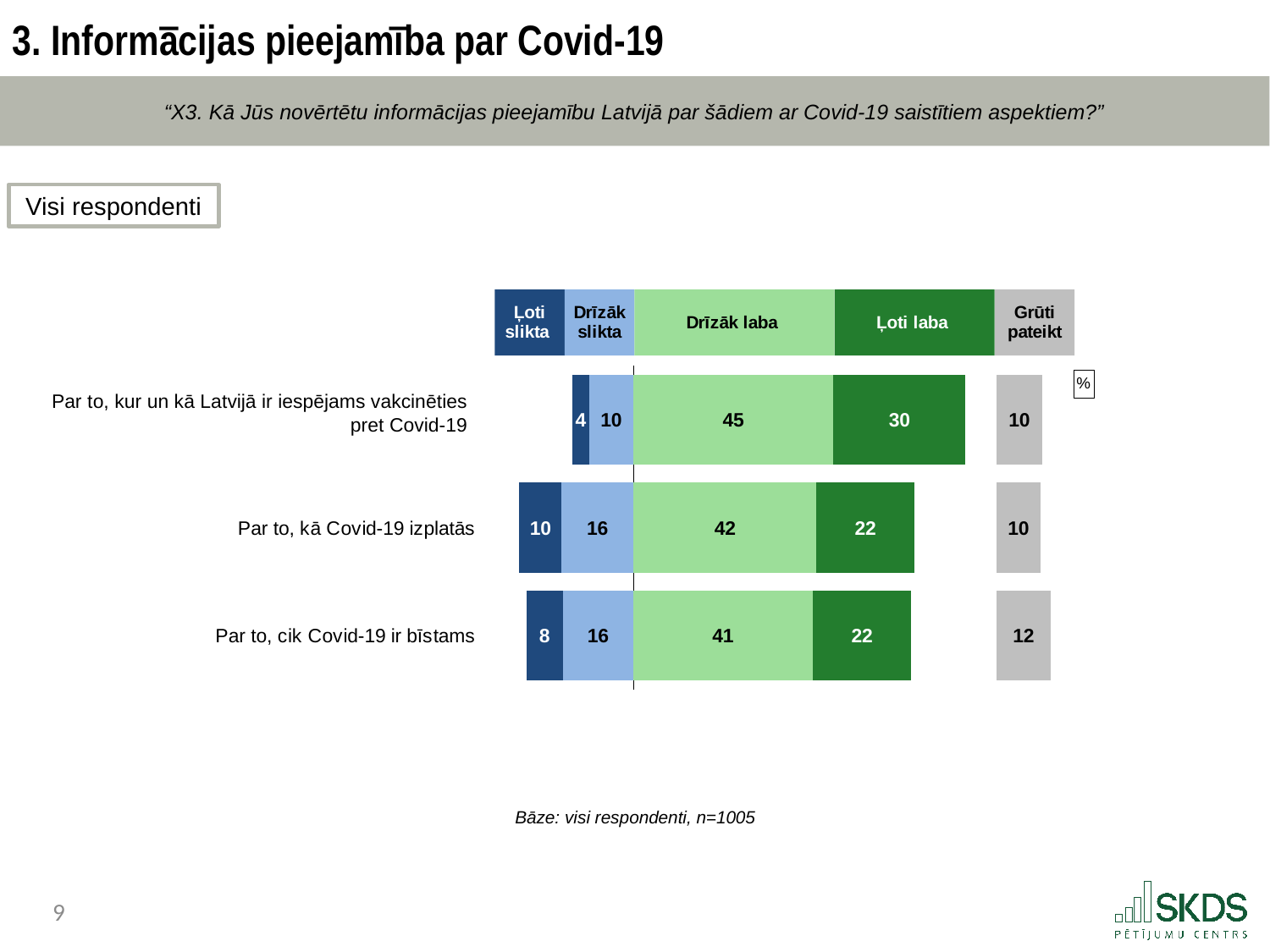
Which aspect has the lowest 'Ļoti slikta' value? Par to, kur un kā Latvijā ir iespējams vakcinēties pret Covid-19 How many categories (aspects) are plotted in the chart? 3 What is the base (n) stated below the chart? n=1005 What is the 'Ļoti slikta' value for 'Par to, kā Covid-19 izplatās'? 10 What is the combined total of 'Drīzāk laba' and 'Ļoti laba' for 'Par to, cik Covid-19 ir bīstams'? 63 Which is larger: the 'Drīzāk slikta' value for 'Par to, kā Covid-19 izplatās' or for 'Par to, kur un kā Latvijā ir iespējams vakcinēties pret Covid-19'? Par to, kā Covid-19 izplatās What is the 'Drīzāk laba' value for 'Par to, kur un kā Latvijā ir iespējams vakcinēties pret Covid-19'? 45 How many response categories (series) does the legend list? 5 What is the difference between the 'Ļoti laba' values for 'Par to, kur un kā Latvijā ir iespējams vakcinēties pret Covid-19' and 'Par to, kā Covid-19 izplatās'? 8 Which aspect has the highest 'Ļoti laba' value? Par to, kur un kā Latvijā ir iespējams vakcinēties pret Covid-19 What kind of chart is shown on the slide? Stacked bar chart What is the 'Grūti pateikt' value for 'Par to, cik Covid-19 ir bīstams'? 12